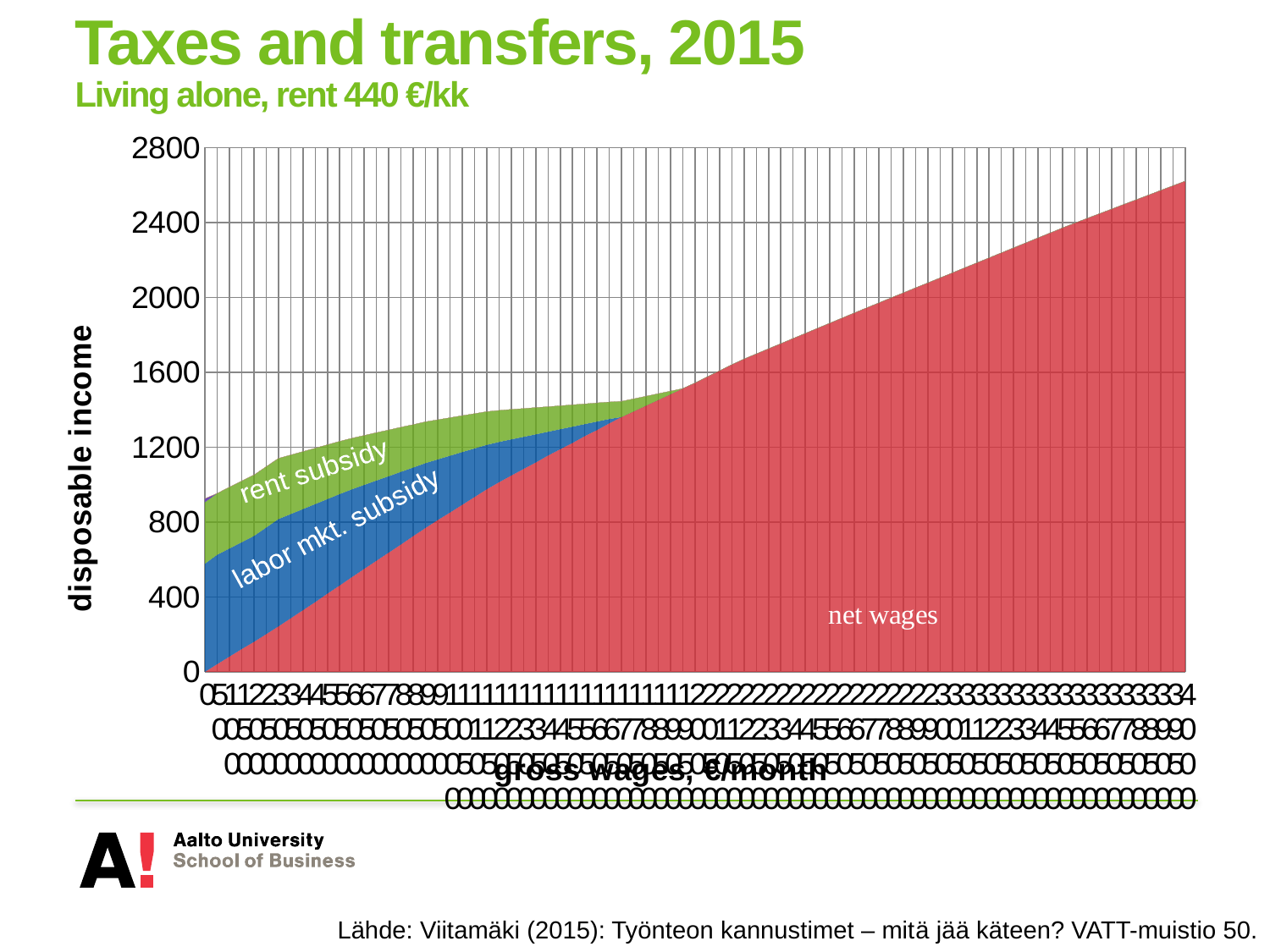
How many series (shaded areas) are shown in the chart? 3 Which series is larger at the right end of the chart: net wages or rent subsidy? net wages Is the total disposable income at the right end of the chart greater or less than 2400? greater What kind of chart is shown on the slide? Stacked area chart Which series is larger at the far left of the chart: labor mkt. subsidy or net wages? labor mkt. subsidy Which series is shown in red in the chart? net wages What is the label of the vertical axis of the chart? disposable income Is the total disposable income at the left end of the chart greater or less than 1200? less What is the highest value shown on the vertical axis of the chart? 2800 Does the net wages area rise or fall as gross wages increase along the x axis? Rise